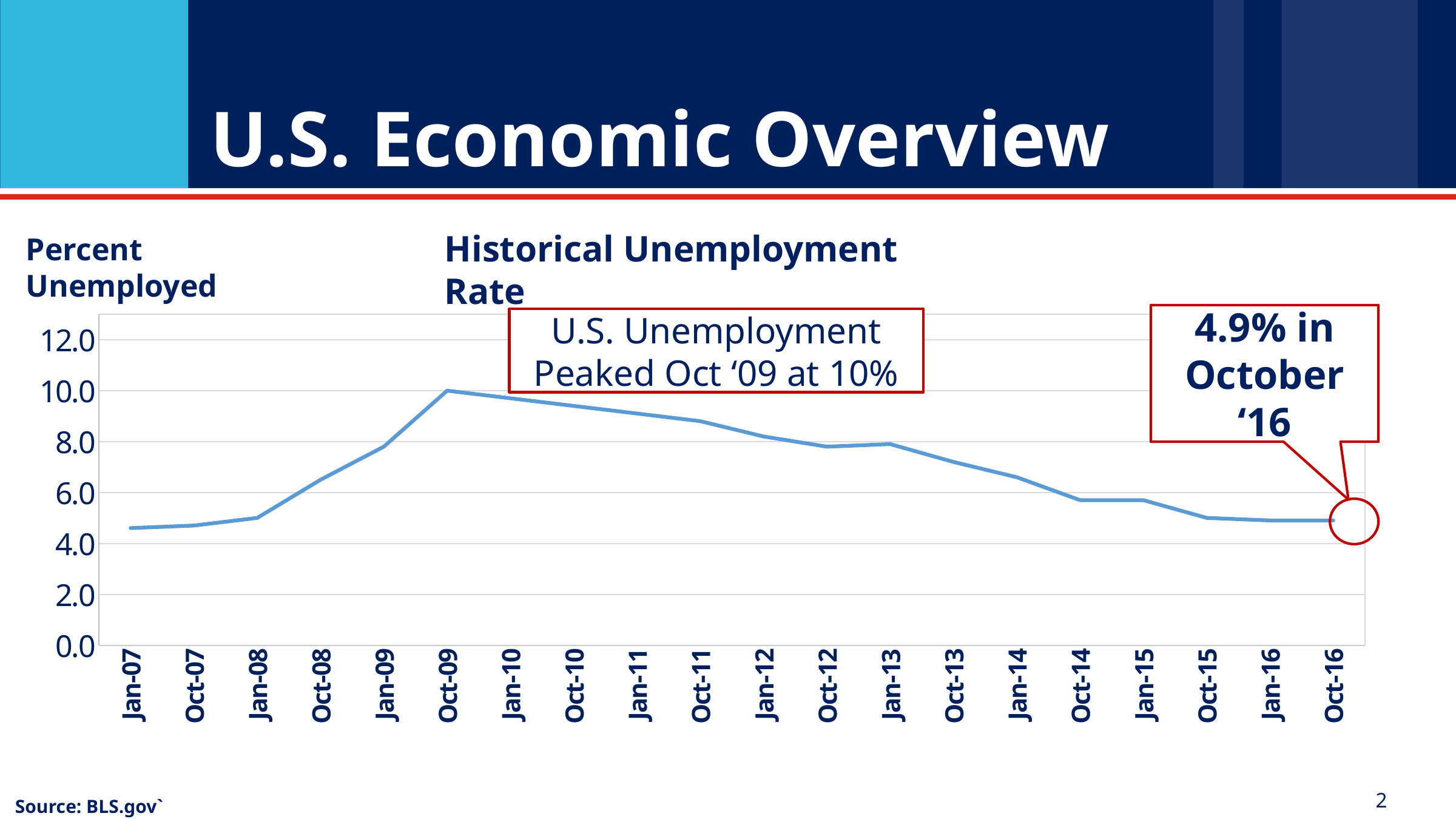
How much higher was the unemployment rate at the Oct '09 peak than in October '16? 5.1 percentage points Is the value for Oct-10 greater or less than 8.0? greater Is the value for Jan-07 greater or less than 6.0? less What was the U.S. unemployment rate at its peak in October 2009? 10% Which is larger, the value for Jan-08 or the value for Oct-08? Oct-08 Does the unemployment rate rise or fall from Oct-09 to Oct-16? Fall At which date does the unemployment rate reach its highest point? Oct-09 What kind of chart is shown on the slide? Line chart Is the value for Oct-14 greater or less than 6.0? less What was the unemployment rate in October 2016? 4.9% What is the title of the chart? Historical Unemployment Rate How many dates are labelled on the x axis? 20